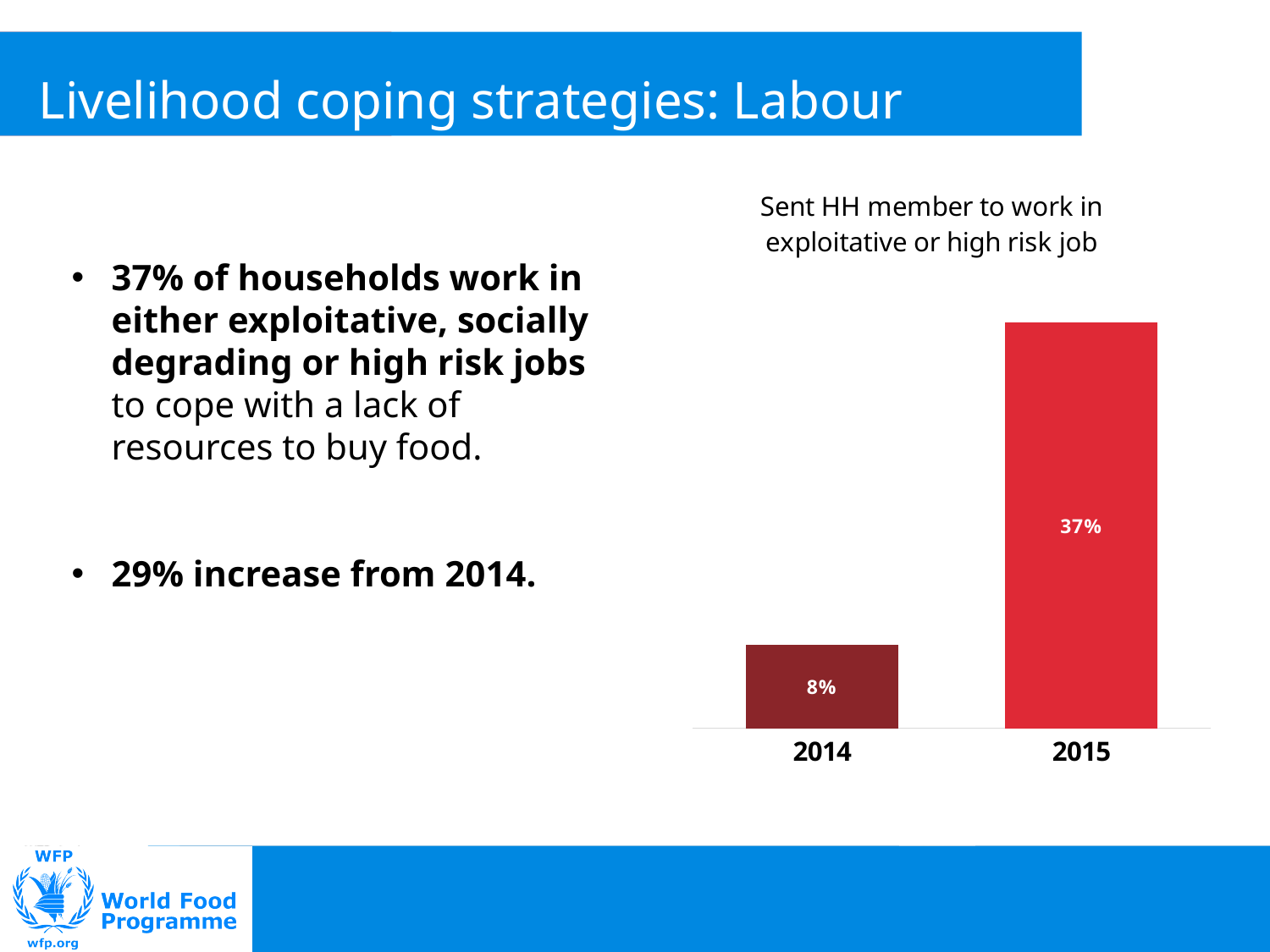
How many categories are shown on the x axis of the chart? 2 What is the value for 2015 in the chart? 37% What is the difference between the 2015 and 2014 values in the chart? 29% Do the values rise or fall from 2014 to 2015 in the chart? Rise What colour is the bar for 2015 in the chart? Red What kind of chart is shown on the slide? Bar chart Which year has the highest value in the chart? 2015 What is the value for 2014 in the chart? 8% Which is larger in the chart, the value for 2014 or the value for 2015? 2015 What is the title of the chart? Sent HH member to work in exploitative or high risk job Which year has the lowest value in the chart? 2014